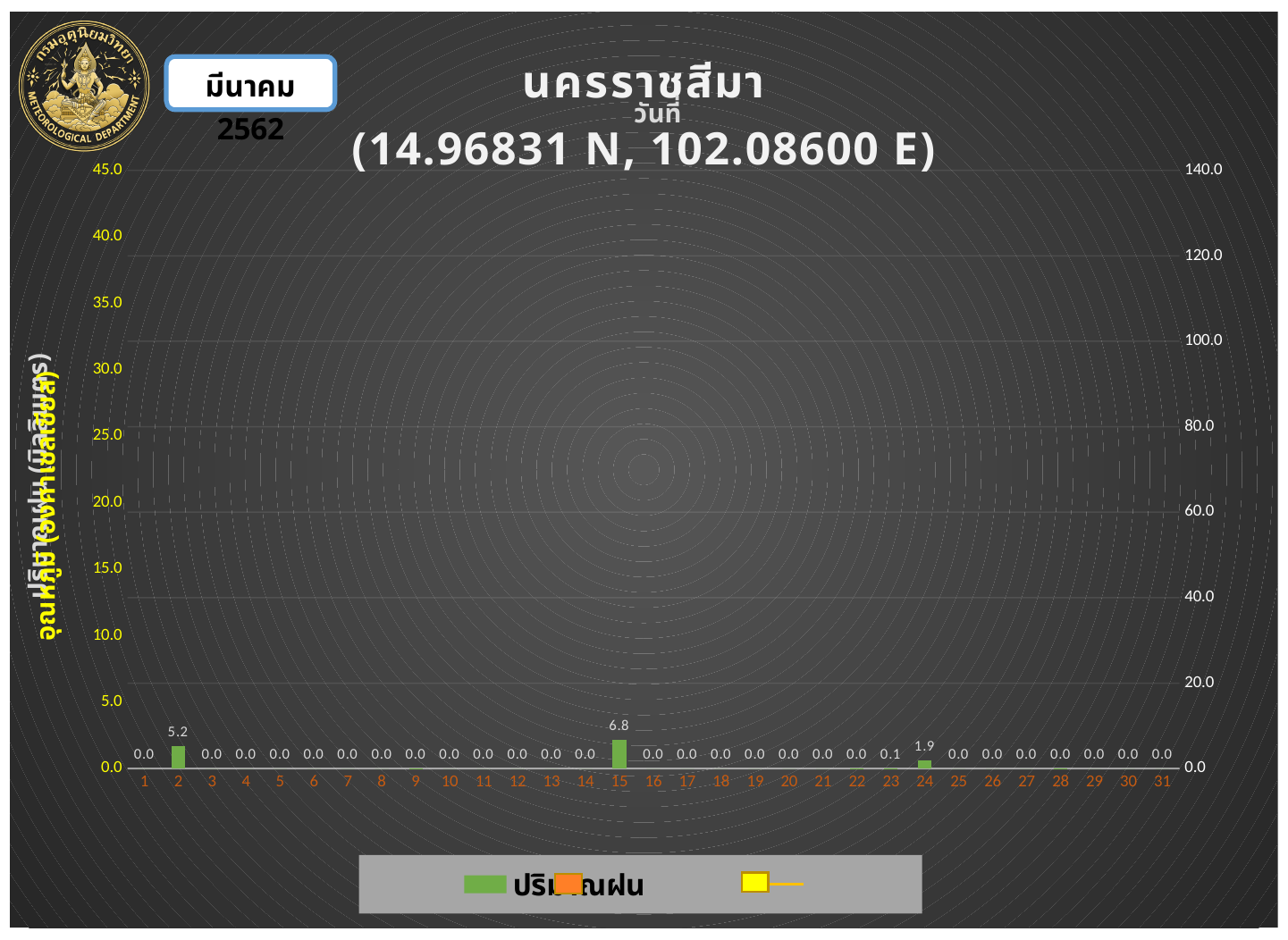
What is the rainfall value shown for day 15? 6.8 What label does the legend give to the green bars? ปริมาณฝน What is the rainfall value shown for day 24? 1.9 How many days are shown on the x axis? 31 What is the difference between the rainfall values for day 15 and day 2? 1.6 What is the rainfall value shown for day 2? 5.2 What is the rainfall value shown for day 23? 0.1 What station name appears in the chart title? นครราชสีมา What kind of chart is used to show the rainfall data? bar chart Is the rainfall value for day 15 greater or less than 10.0 on the left axis? less Which has the larger rainfall value, day 2 or day 24? day 2 Which day has the highest rainfall value? 15